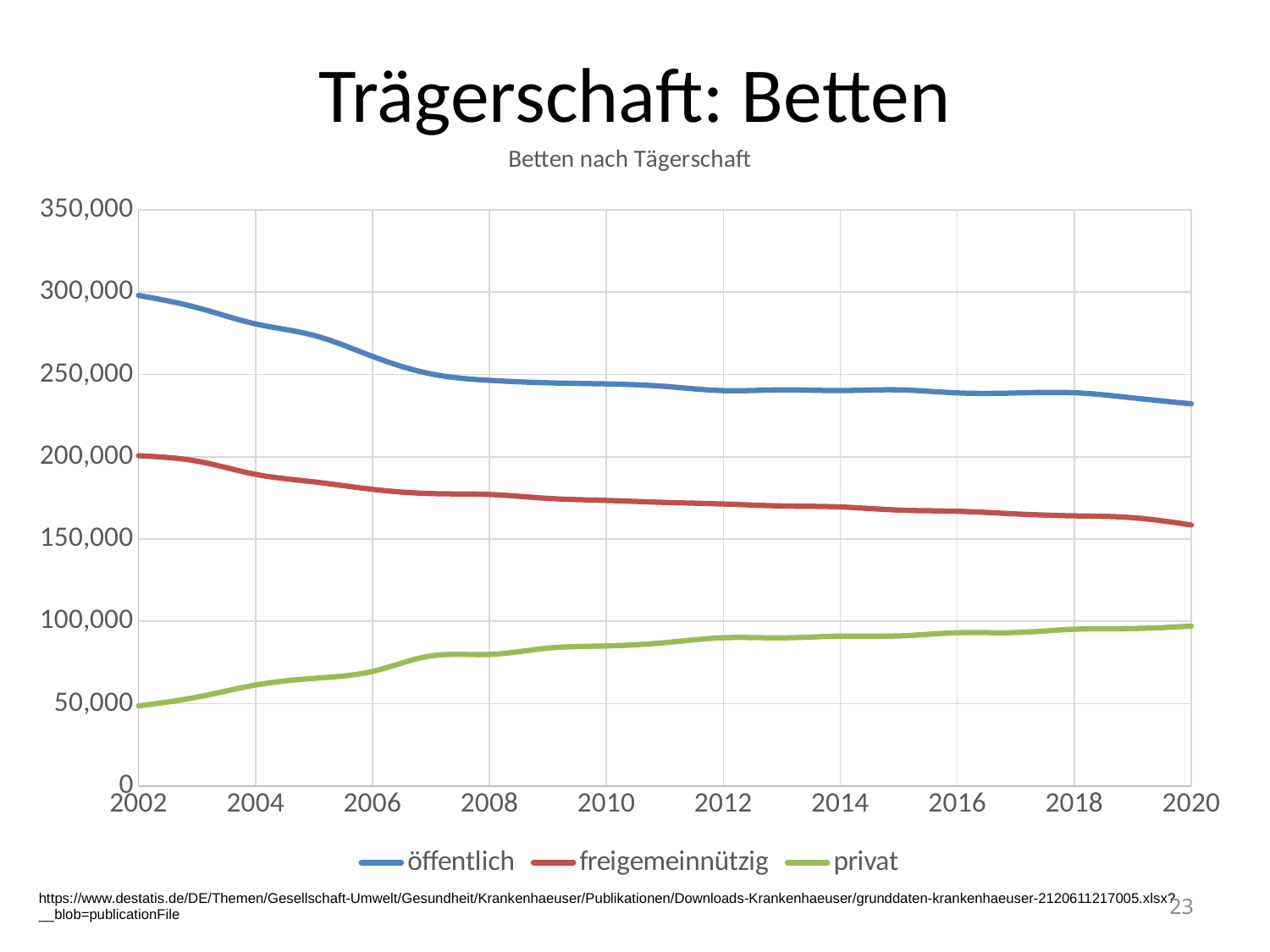
What kind of chart is shown on the slide? line chart Does the value for freigemeinnützig rise or fall from 2002 to 2020? fall Is the value for privat in 2020 greater or less than 100,000? less Is the value for öffentlich in 2002 greater or less than 250,000? greater How many series does the legend list? 3 Which series is drawn in green? privat Which series has the highest value in 2020? öffentlich Is the value for öffentlich in 2020 greater or less than 250,000? less Does the value for öffentlich rise or fall from 2002 to 2020? fall Does the value for privat rise or fall from 2002 to 2020? rise Which series has the lowest value in 2010? privat What is the title of the chart? Betten nach Tägerschaft